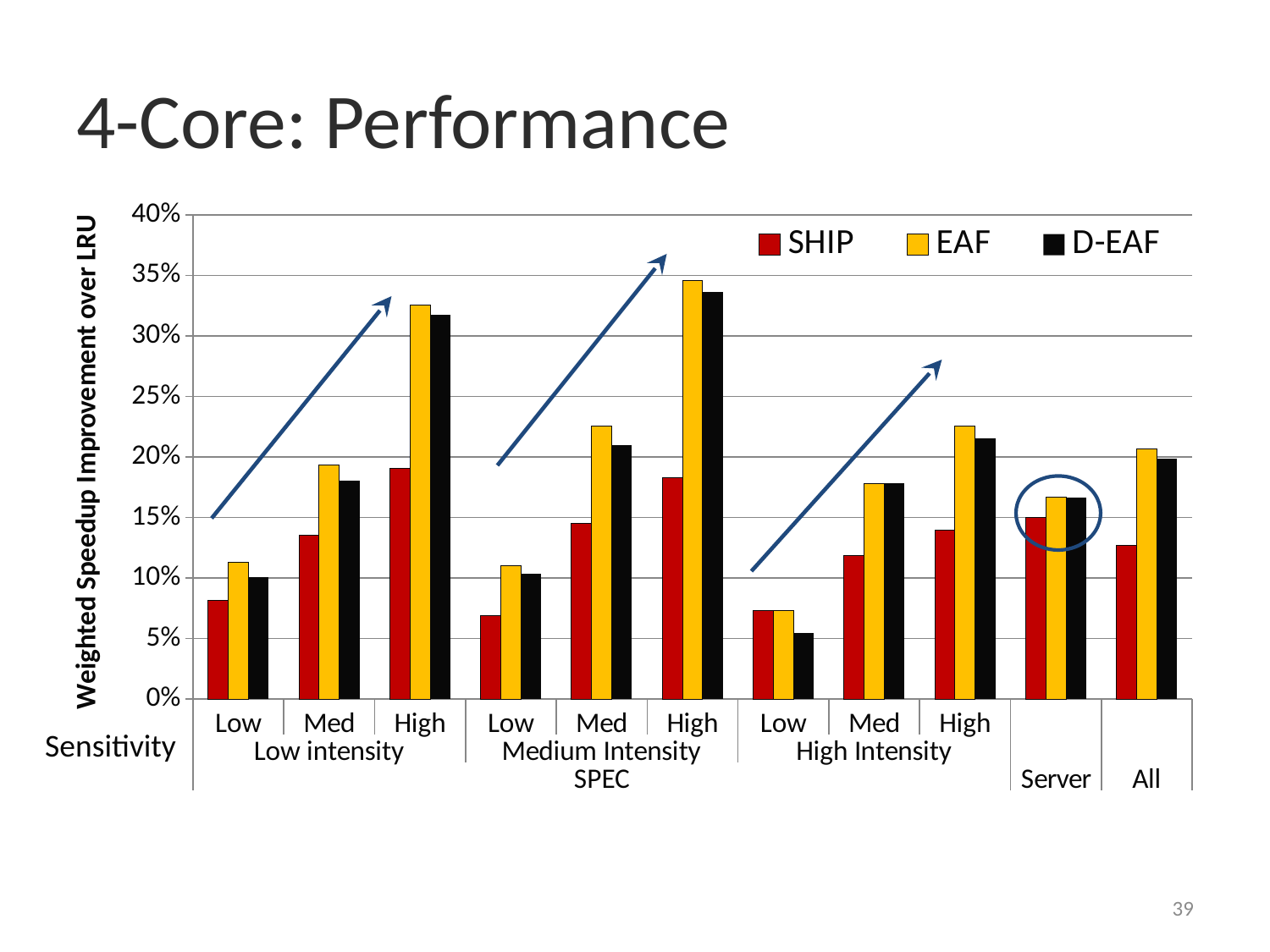
Is the SHIP value for Low sensitivity in the Low intensity group greater or less than 10%? less Within the Low intensity group, do the EAF bars rise or fall from Low to High sensitivity? rise What kind of chart is shown on the slide? bar chart What is the title of the y axis? Weighted Speedup Improvement over LRU For Low sensitivity in the High Intensity group, which series has the lowest bar? D-EAF How many category groups (sets of bars) are plotted along the x axis? 11 For High sensitivity in the Low intensity group, which is larger, the EAF bar or the SHIP bar? EAF Which series is shown in red in the legend? SHIP How many series does the legend list? 3 Is the EAF value for High sensitivity in the Medium Intensity group greater or less than 30%? greater Which category group has the tallest EAF bar? High sensitivity, Medium Intensity Is the SHIP value for the All group greater or less than 15%? less